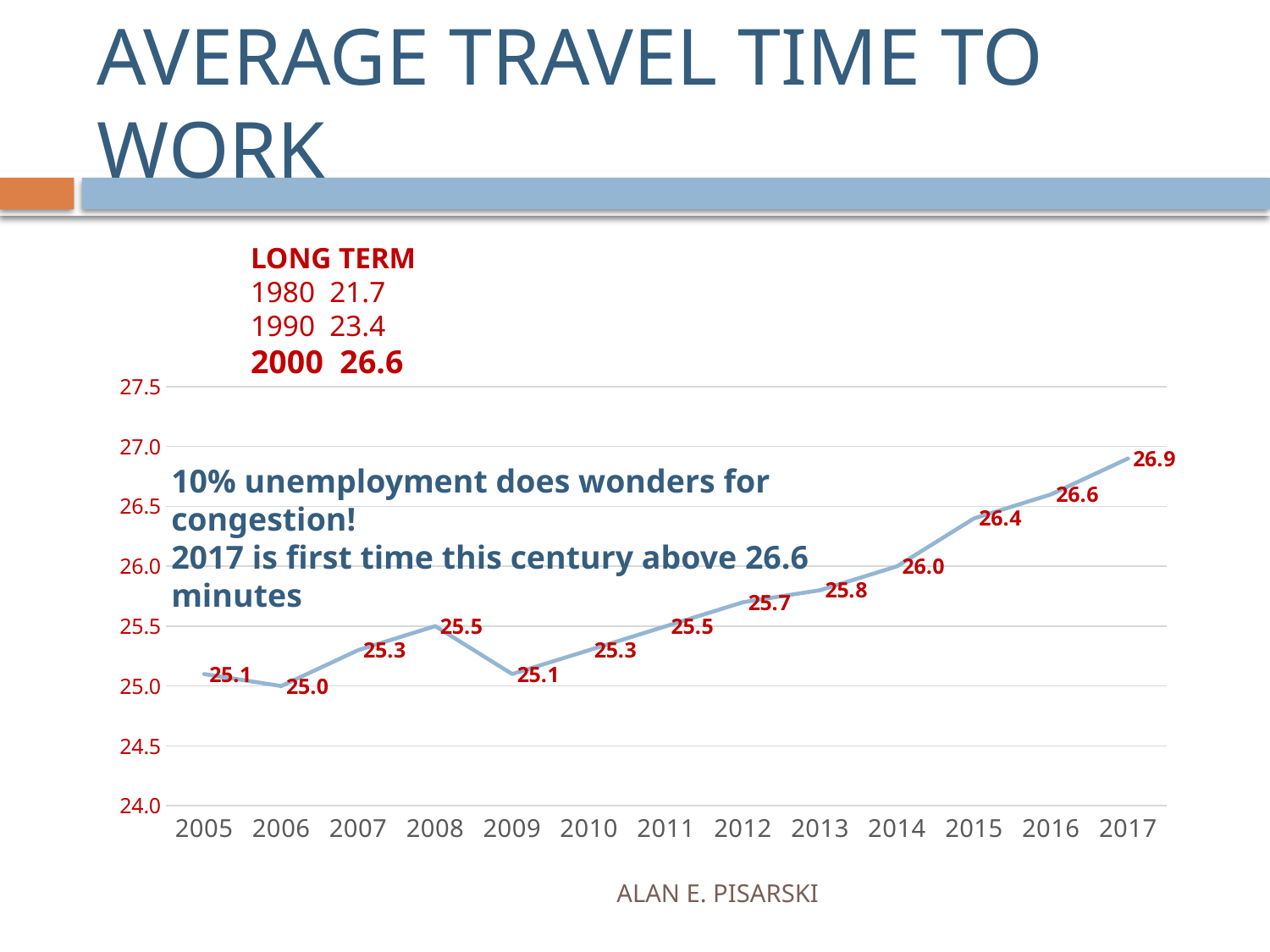
What kind of chart is shown on the slide? Line chart What is the difference between the average travel time in 2017 and in 2005? 1.8 Which year has a higher average travel time, 2008 or 2011? They are equal (25.5) Which year has a higher average travel time, 2014 or 2012? 2014 Is the value for 2015 greater or less than 26.0? greater Which year has the highest average travel time to work? 2017 Do the values generally rise or fall from 2009 to 2017? Rise How many years are plotted on the x axis? 13 What is the average travel time to work in 2009? 25.1 Which year has the lowest average travel time to work? 2006 What is the average travel time to work in 2017? 26.9 What is the average travel time to work in 2013? 25.8